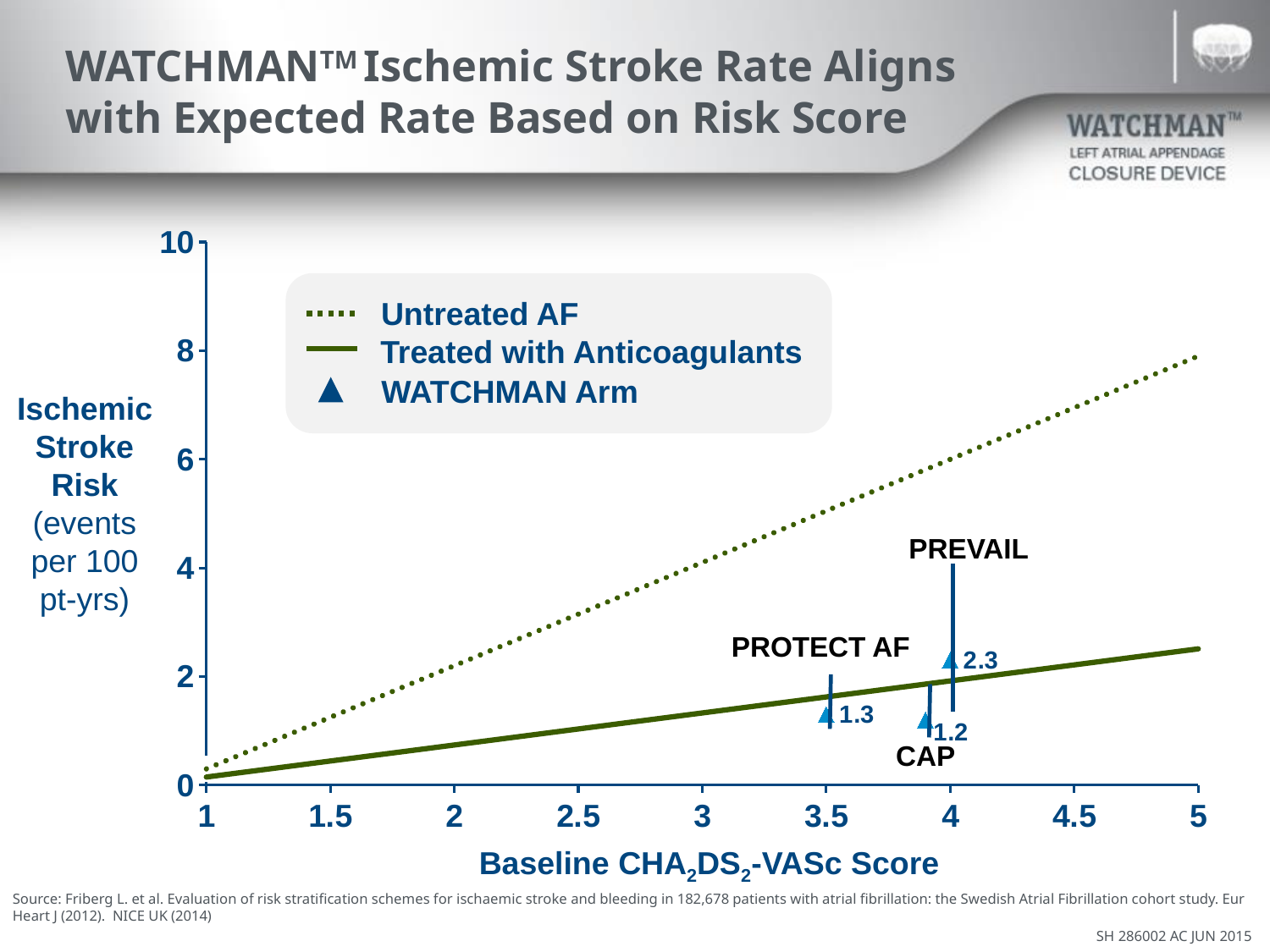
Does the Untreated AF line rise or fall as the baseline CHA2DS2-VASc score increases? rise What is the ischemic stroke risk value labelled for the PREVAIL point? 2.3 What is the ischemic stroke risk value labelled for the CAP point? 1.2 What is the difference between the PREVAIL value and the PROTECT AF value? 1.0 Is the Untreated AF value at a CHA2DS2-VASc score of 5 greater or less than 6? greater What is the ischemic stroke risk value labelled for the PROTECT AF point? 1.3 Which of the three WATCHMAN Arm points (PROTECT AF, CAP, PREVAIL) has the highest ischemic stroke risk? PREVAIL How many series does the legend list? 3 Is the Treated with Anticoagulants value at a CHA2DS2-VASc score of 5 greater or less than 4? less Which of the three WATCHMAN Arm points (PROTECT AF, CAP, PREVAIL) has the lowest ischemic stroke risk? CAP Which legend entry is shown with a dotted line? Untreated AF Which is larger, the PREVAIL value or the CAP value? PREVAIL